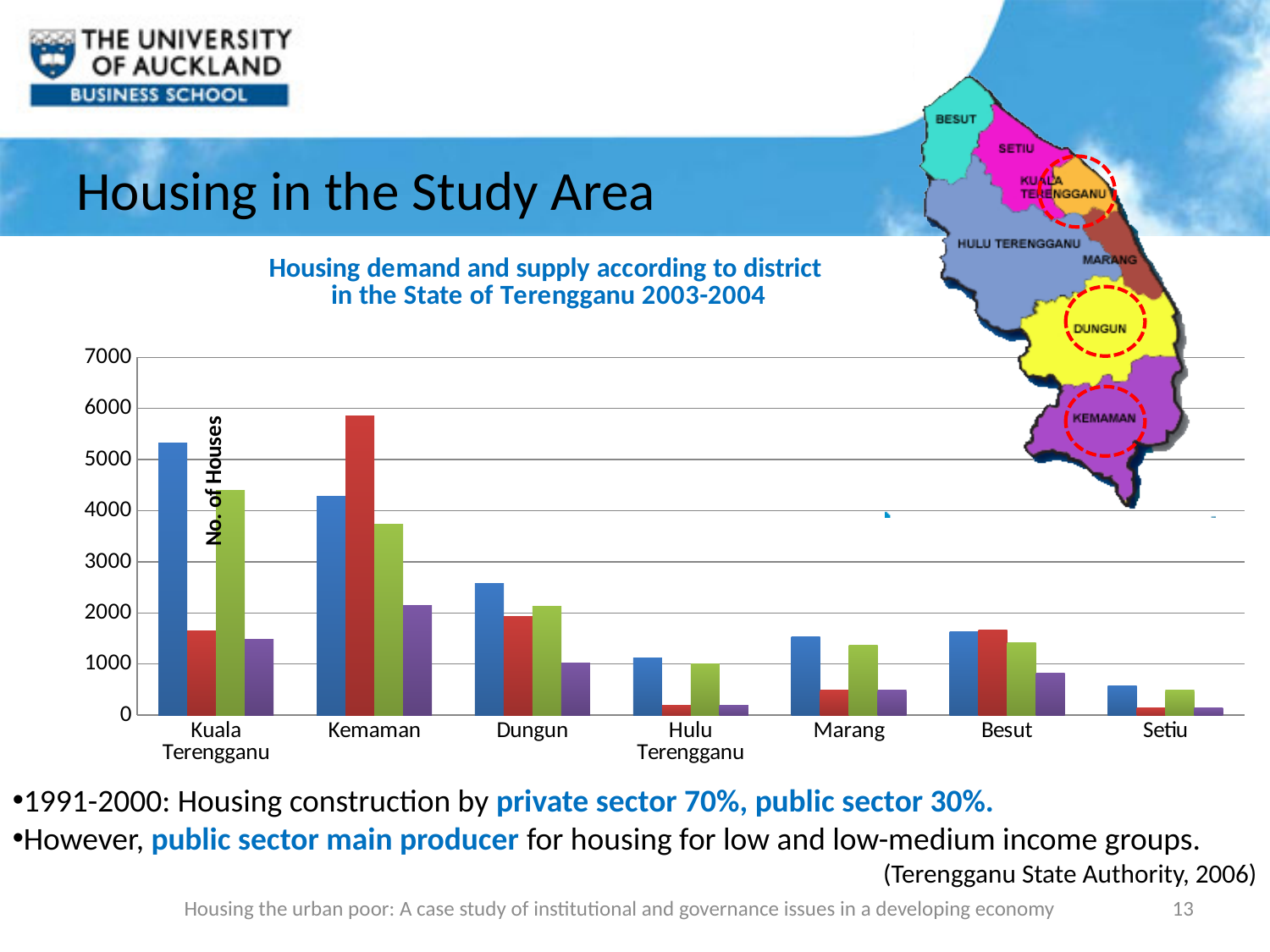
Is the value of the green bar for Kemaman greater or less than 4000? less How many districts are shown on the x axis of the chart? 7 Which district has the tallest blue bar? Kuala Terengganu Which district has the tallest purple bar? Kemaman Is the value of the blue bar for Kuala Terengganu greater or less than 5000? greater For Kemaman, which is larger: the blue bar or the red bar? the red bar What is the label on the vertical axis of the chart? No. of Houses What is the title of the chart? Housing demand and supply according to district in the State of Terengganu 2003-2004 What kind of chart is shown on the slide? bar chart Which district has the tallest red bar? Kemaman Which district has the shortest blue bar? Setiu Is the value of the blue bar for Dungun greater or less than 2000? greater